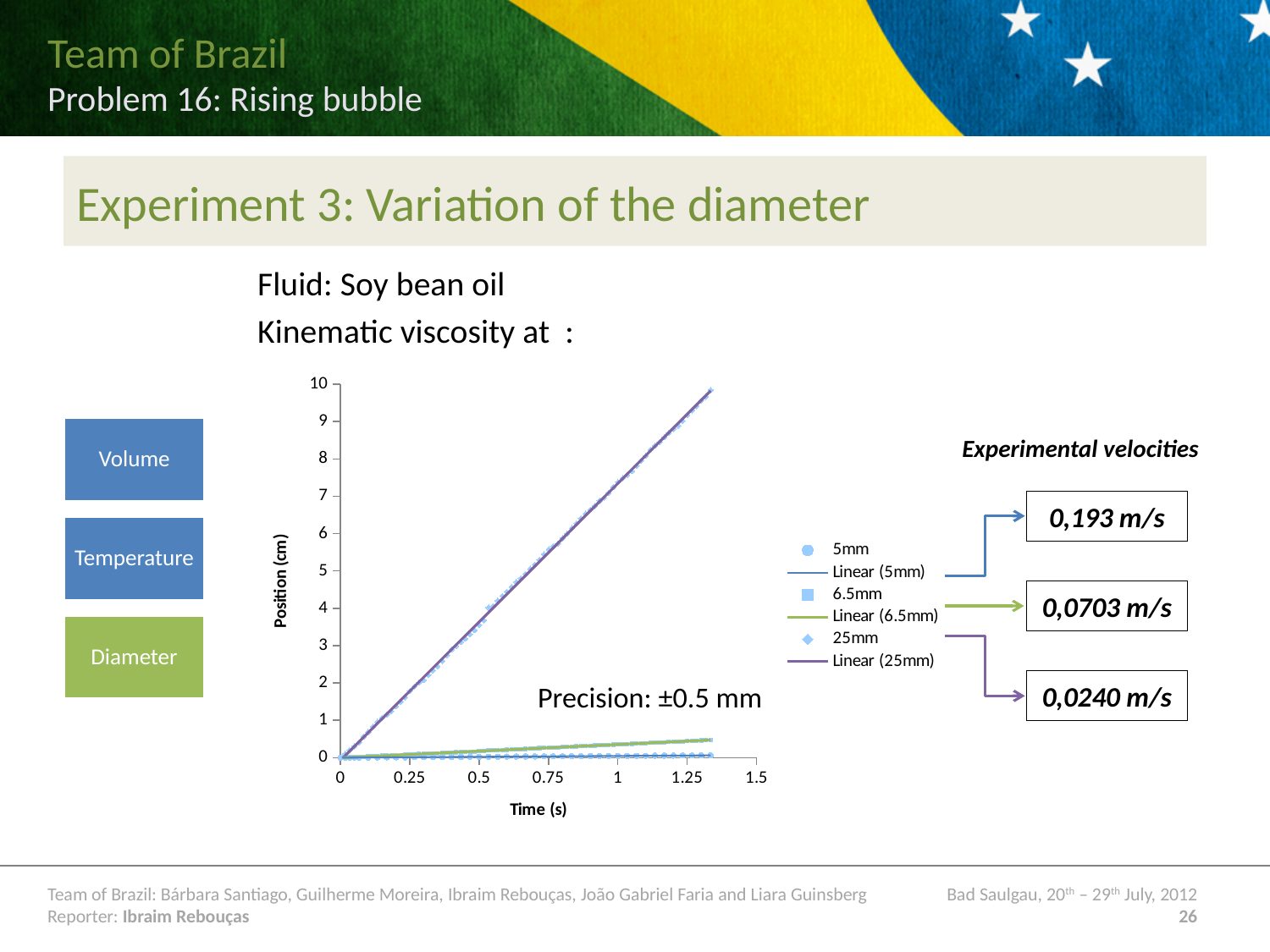
Does the position of the 25mm series rise or fall as time increases? rise Which series has a higher position at 1 s, 6.5mm or 5mm? 6.5mm Which series stays lowest on the chart? 5mm What is the title of the chart's horizontal axis? Time (s) Is the position of the 25mm series at 0.5 s greater or less than 3? greater What is the highest value shown on the chart's vertical axis? 10 Is the position of the 6.5mm series at 1.25 s greater or less than 1? less What is the title of the chart's vertical axis? Position (cm) Which series reaches the highest position on the chart? 25mm What kind of chart is shown on the slide? scatter chart How many entries does the chart legend list? 6 Is the position of the 5mm series at 1.25 s greater or less than 1? less